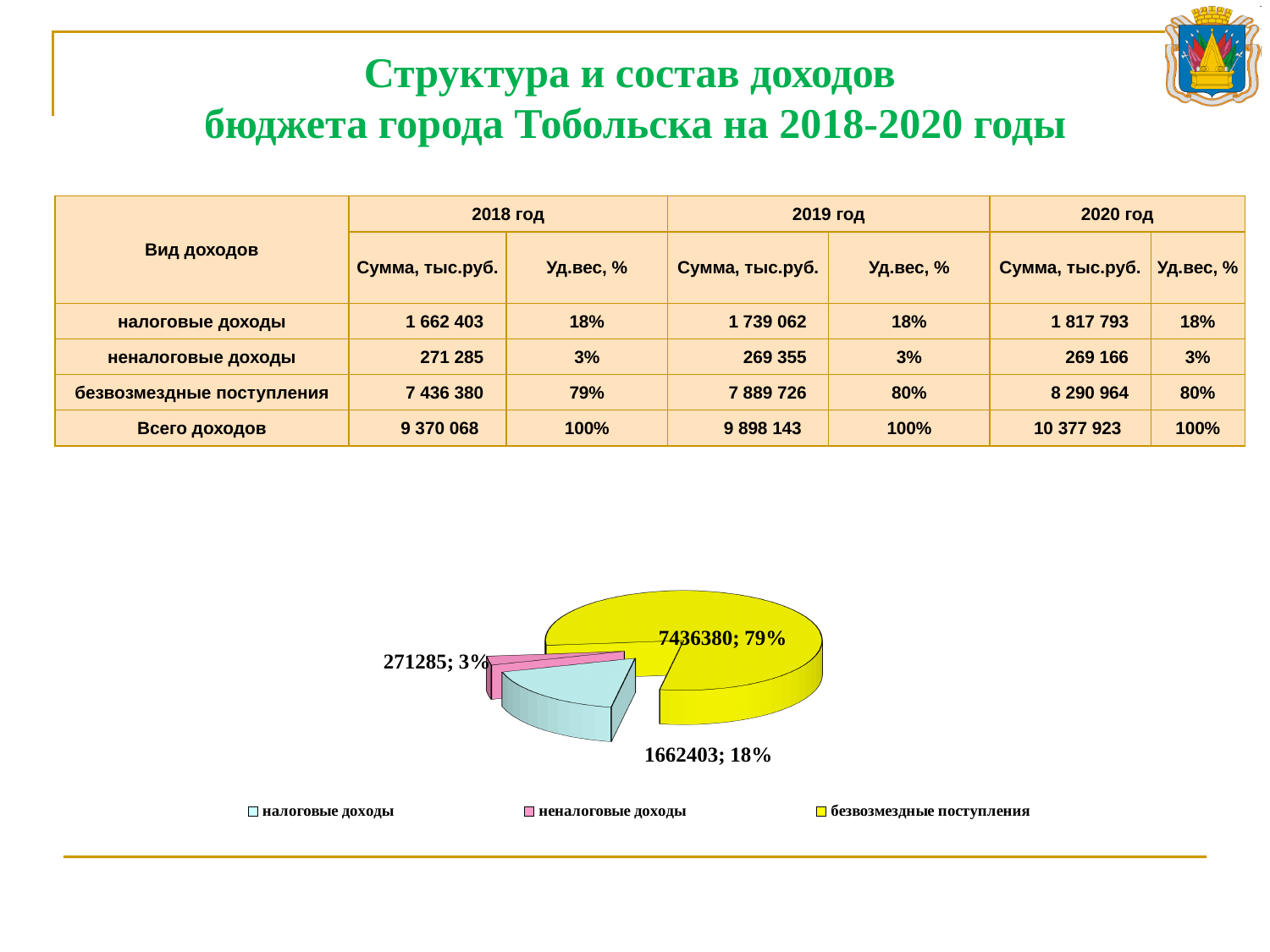
In the pie chart, what share is shown for налоговые доходы? 18% In the pie chart, what is the difference between the values for безвозмездные поступления and налоговые доходы? 5773977 In the pie chart, what value is shown for безвозмездные поступления? 7436380 Which category has the largest slice in the pie chart? безвозмездные поступления How many entries does the pie chart legend list? 3 In the pie chart, which is larger: налоговые доходы or неналоговые доходы? налоговые доходы In the pie chart, what share is shown for неналоговые доходы? 3% How many slices does the pie chart have? 3 In the pie chart, what share is shown for безвозмездные поступления? 79% What kind of chart is shown on the slide? pie chart In the pie chart, what value is shown for налоговые доходы? 1662403 Which category has the smallest slice in the pie chart? неналоговые доходы